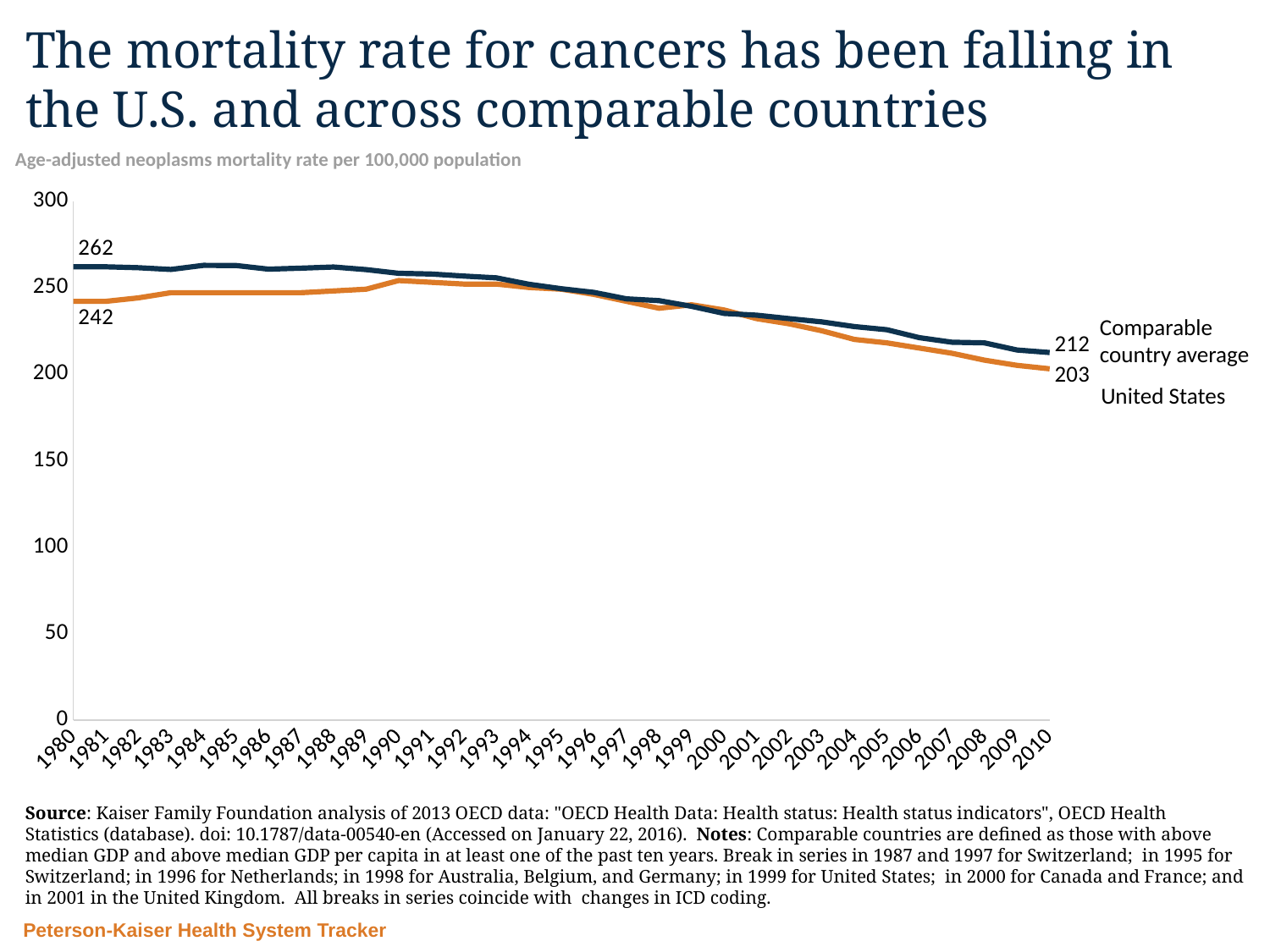
What was the United States age-adjusted neoplasms mortality rate per 100,000 population in 1980? 242 What was the United States mortality rate in 2010? 203 What was the comparable country average mortality rate in 2010? 212 What was the comparable country average age-adjusted neoplasms mortality rate per 100,000 population in 1980? 262 By how much did the United States mortality rate fall between 1980 and 2010? 39 Is the United States mortality rate in 2000 greater or less than 250? less What kind of chart is shown on the slide? Line chart What is the overall trend of the United States mortality rate from 1980 to 2010? Falling How many series are plotted on the chart? 2 In 1980, which was higher: the United States mortality rate or the comparable country average? Comparable country average By how much did the comparable country average mortality rate fall between 1980 and 2010? 50 In 2010, what was the difference between the comparable country average and the United States mortality rate? 9